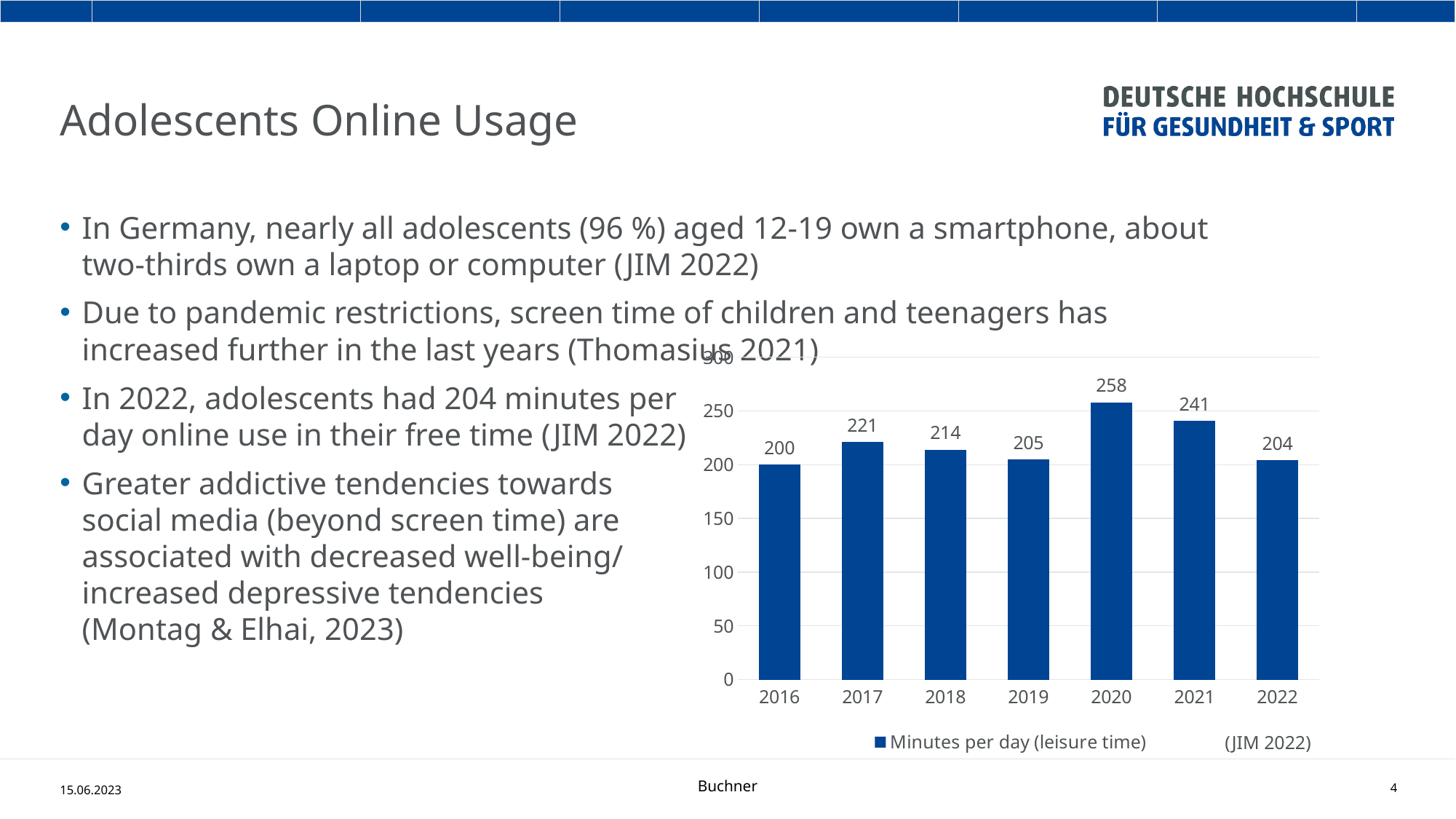
Which is larger, the value for 2017 or the value for 2018? 2017 Is the value for 2021 greater or less than 200? greater Which year has the highest value in the chart? 2020 How many years are shown on the x axis of the chart? 7 What is the value for 2016 in the chart? 200 Which year has the lowest value in the chart? 2016 What is the value for 2020 in the chart? 258 What is the value for 2022 in the chart? 204 What is the legend entry of the series in the chart? Minutes per day (leisure time) How many series does the chart legend list? 1 What kind of chart is shown on the slide? bar chart What is the difference between the values for 2020 and 2022? 54